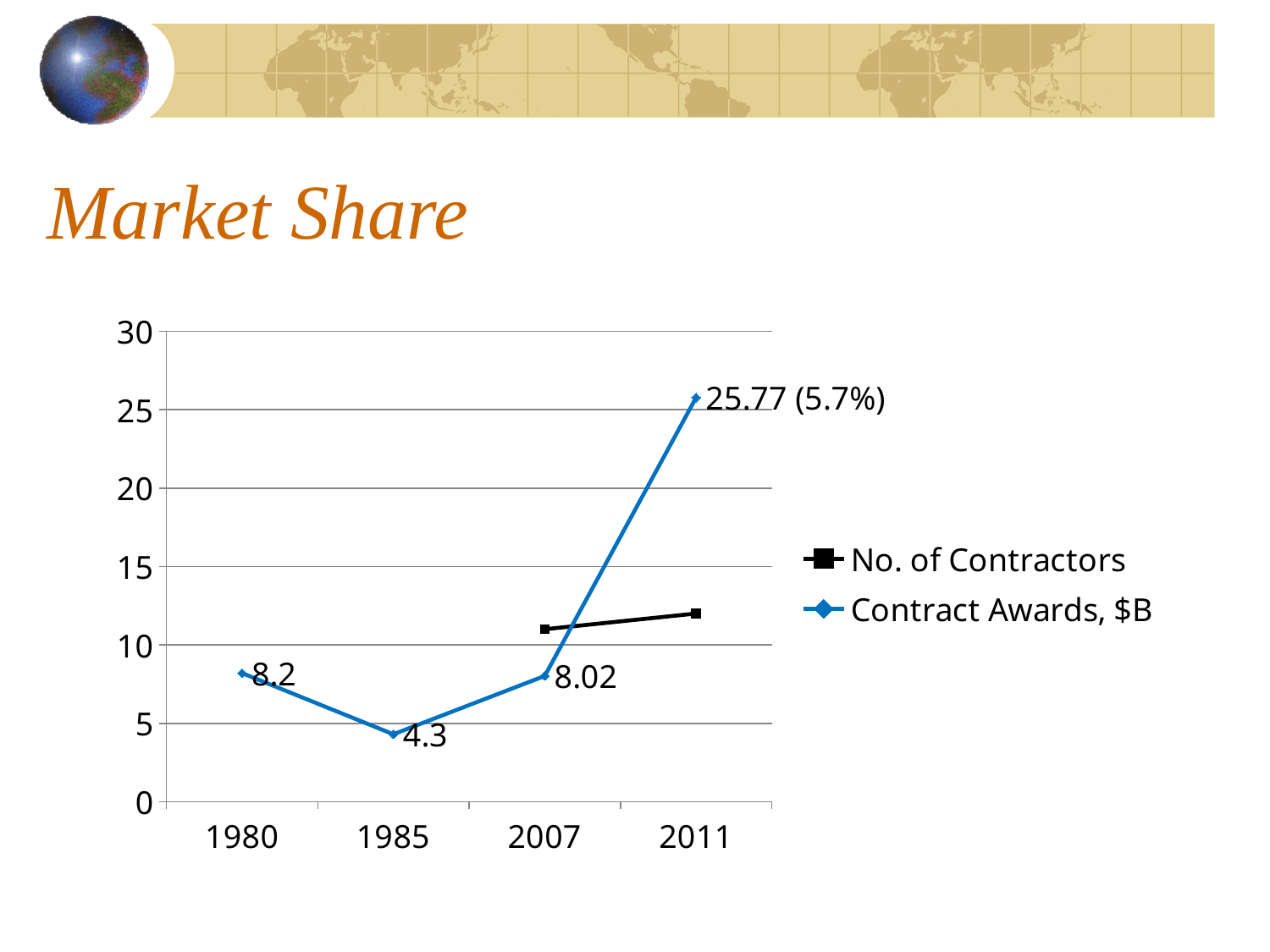
Is the value for No. of Contractors in 2007 greater or less than 10? greater What is the value of Contract Awards, $B in 1985? 4.3 What is the difference between Contract Awards, $B in 2011 and in 2007? 17.75 What percentage is shown next to the 2011 Contract Awards data point? 5.7% How many years are shown on the x axis? 4 In which year is Contract Awards, $B lowest? 1985 What kind of chart is shown on the slide? Line chart Which year has the larger Contract Awards, $B value, 1980 or 1985? 1980 In which year is Contract Awards, $B highest? 2011 What is the value of Contract Awards, $B in 2011? 25.77 How many series does the legend list? 2 What is the value of Contract Awards, $B in 2007? 8.02